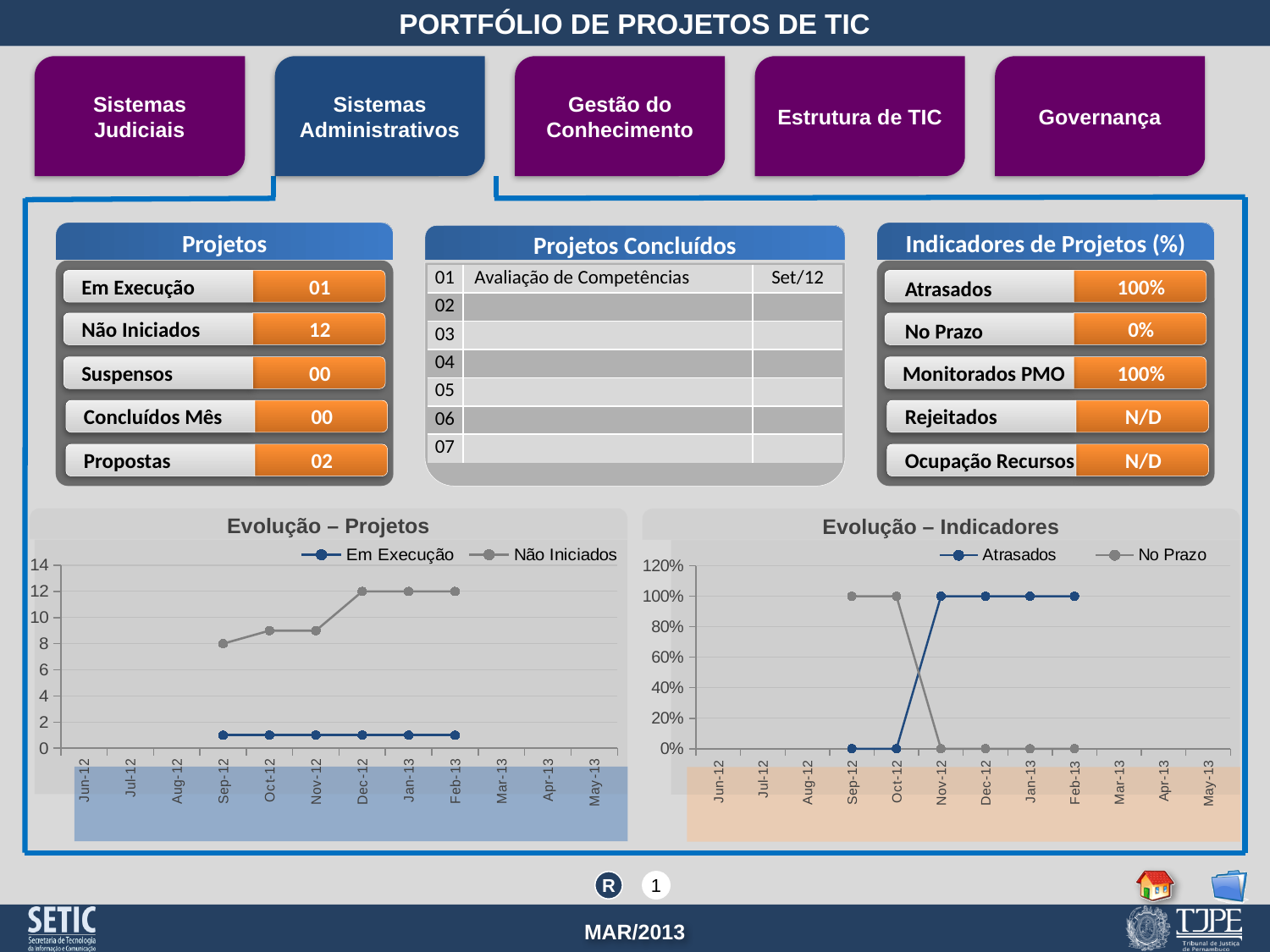
On the 'Evolução – Indicadores' chart, what is the value for Atrasados in Oct-12? 0% On the 'Evolução – Projetos' chart, does the Não Iniciados series rise or fall from Sep-12 to Feb-13? rise On the 'Evolução – Projetos' chart, what is the value for Não Iniciados in Sep-12? 8 On the 'Evolução – Projetos' chart, which series is higher in Nov-12, Em Execução or Não Iniciados? Não Iniciados On the 'Evolução – Projetos' chart, is the value for Em Execução in Jan-13 greater or less than 2? less On the 'Evolução – Projetos' chart, what kind of chart is it? line chart On the 'Evolução – Indicadores' chart, what is the value for Atrasados in Feb-13? 100% On the 'Evolução – Indicadores' chart, which series is shown in blue? Atrasados On the 'Evolução – Projetos' chart, what is the value for Não Iniciados in Dec-12? 12 On the 'Evolução – Indicadores' chart, what is the value for No Prazo in Sep-12? 100% On the 'Evolução – Projetos' chart, how many series does the legend list? 2 On the 'Evolução – Indicadores' chart, what is the difference between Atrasados and No Prazo in Dec-12? 100%